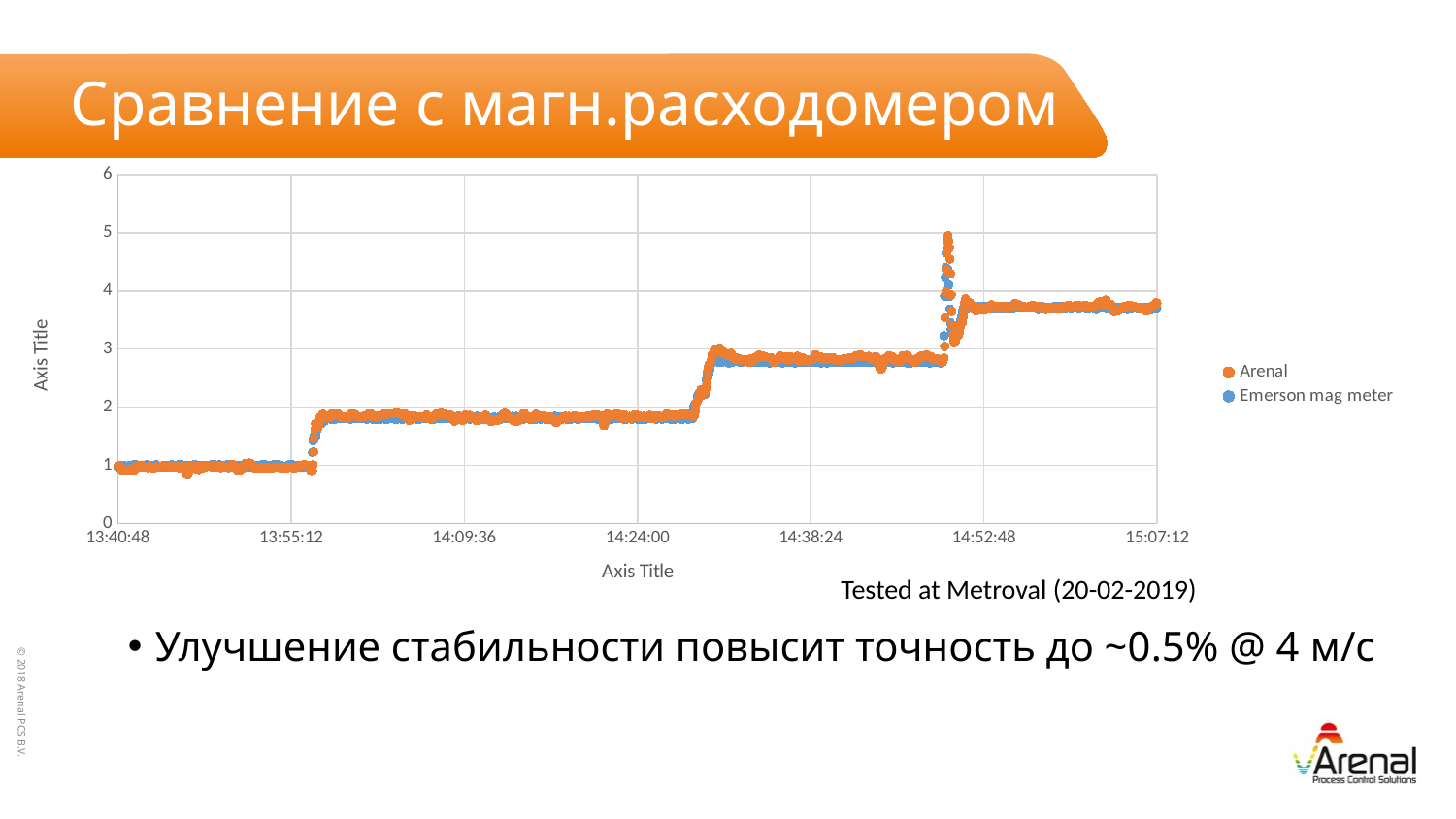
What kind of chart is shown on the slide? scatter chart Is the value of the Emerson mag meter series at 14:09:36 greater or less than 1? greater Do the plotted values generally rise or fall from left to right along the x axis? rise What are the two series named in the chart legend? Arenal and Emerson mag meter Is the value of the Emerson mag meter series at 14:38:24 greater or less than 4? less Is the value of the Arenal series at 14:38:24 greater or less than 2? greater Which colour represents the Arenal series in the chart? orange How many series does the chart legend list? 2